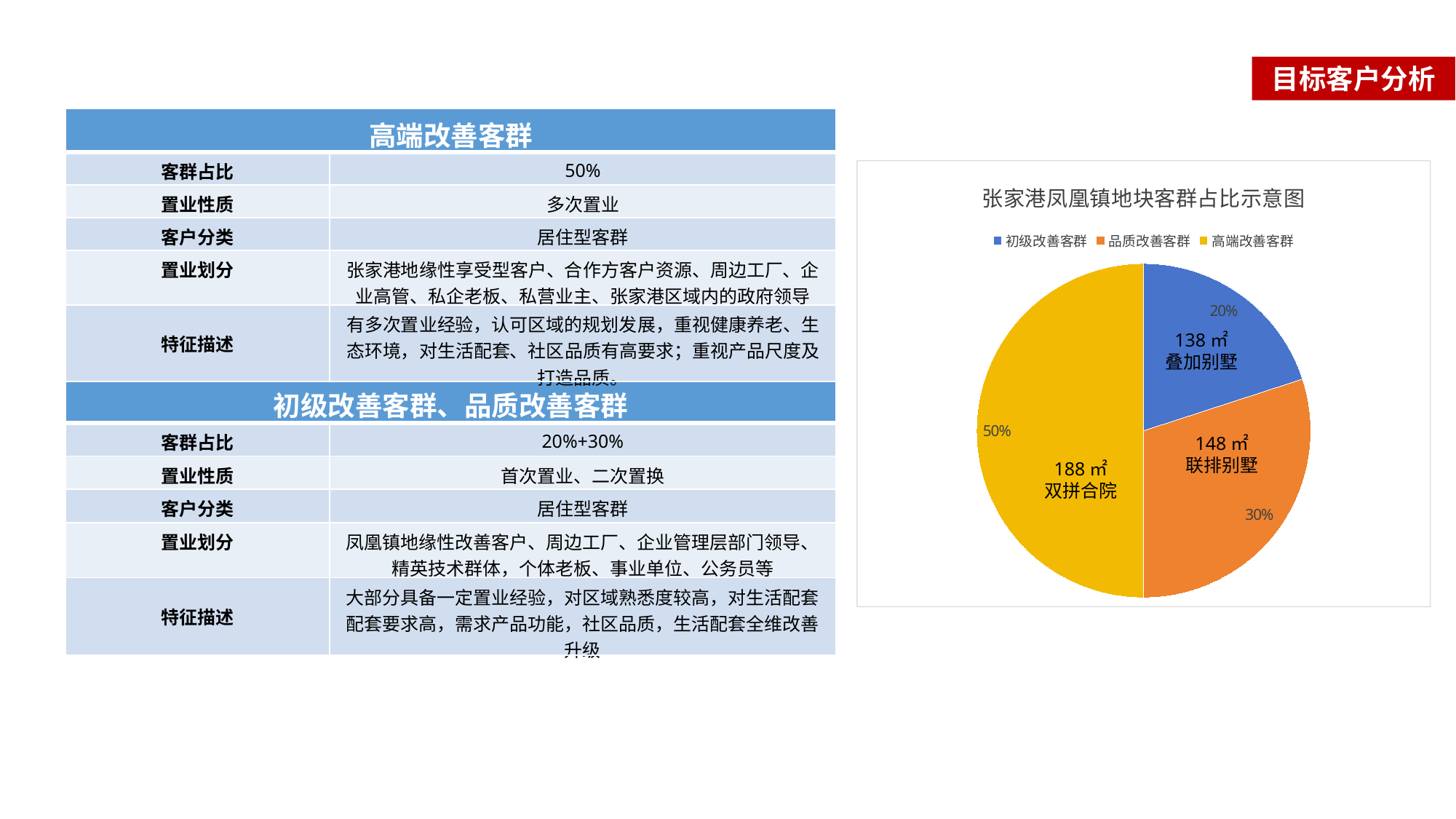
Which category has the smallest slice of the pie? 初级改善客群 How many categories does the legend of the pie chart list? 3 What share of the pie does 初级改善客群 have? 20% Which colour represents 高端改善客群 in the pie chart? yellow What share of the pie does 品质改善客群 have? 30% How many slices does the pie chart have? 3 What kind of chart is shown on the slide? pie chart What is the title of the chart? 张家港凤凰镇地块客群占比示意图 Which category has the largest slice of the pie? 高端改善客群 What share of the pie does 高端改善客群 have? 50% What is the difference in percentage points between the 高端改善客群 slice and the 品质改善客群 slice? 20% Which slice is larger, 品质改善客群 or 初级改善客群? 品质改善客群